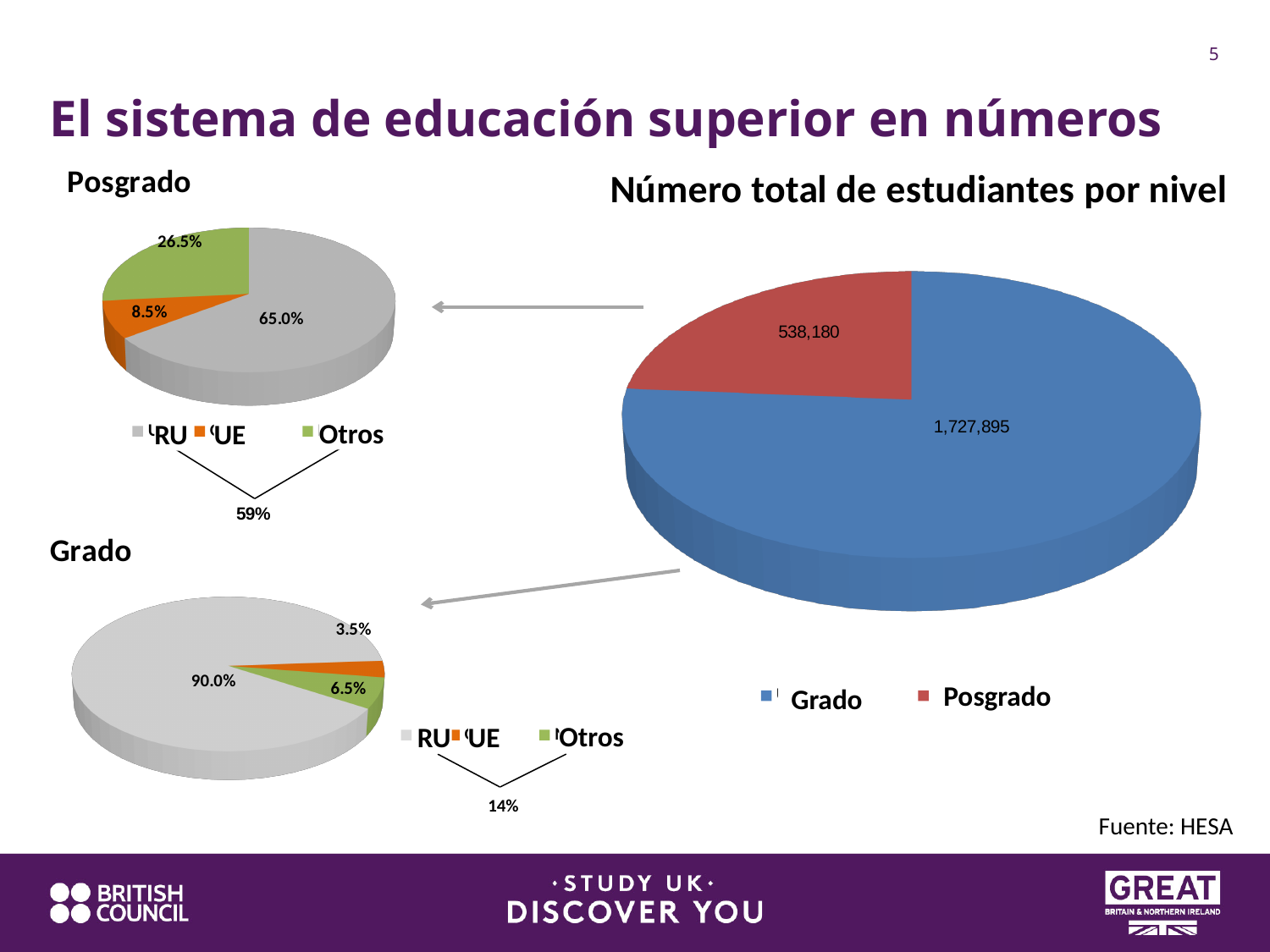
In the 'Posgrado' pie chart, what percentage is shown for UE? 8.5% In the 'Posgrado' pie chart, what percentage is shown for RU? 65.0% How many charts on the slide are pie charts? 3 In the 'Posgrado' pie chart, how many percentage points larger is RU than Otros? 38.5 In the 'Número total de estudiantes por nivel' chart, what is the total of the two values shown? 2,266,075 In the 'Número total de estudiantes por nivel' chart, what is the value for Grado? 1,727,895 In the 'Posgrado' pie chart, which category has the smallest share? UE In the 'Número total de estudiantes por nivel' chart, what is the value for Posgrado? 538,180 In the 'Número total de estudiantes por nivel' chart, what is the difference between the Grado and Posgrado values? 1,189,715 In the 'Posgrado' pie chart, what percentage is shown for Otros? 26.5% In the 'Número total de estudiantes por nivel' chart, which level has the larger number of students? Grado In the 'Grado' pie chart, what percentage is shown for RU? 90.0%